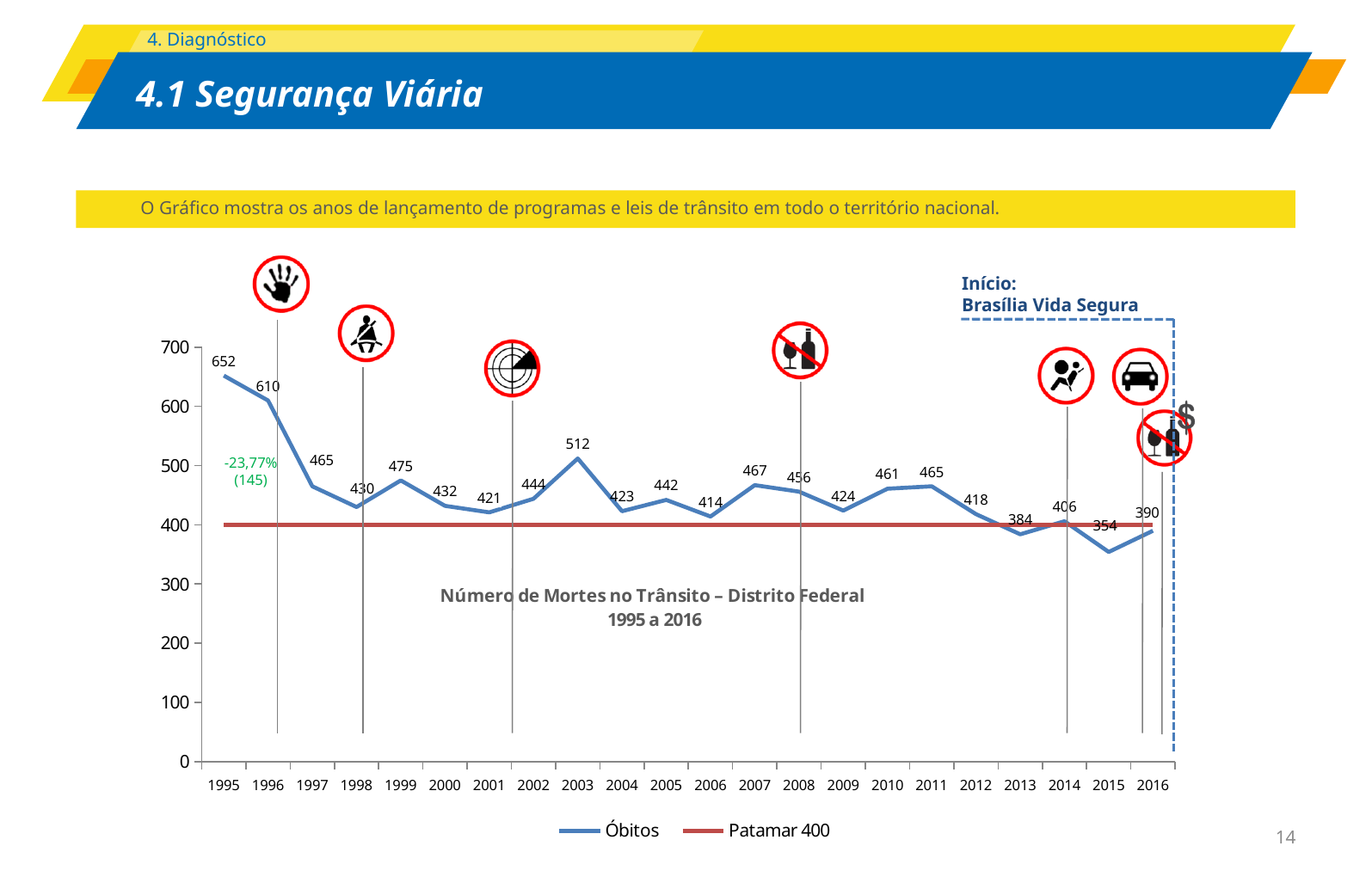
Which year has the highest number of deaths (Óbitos)? 1995 What is the number of deaths (Óbitos) in 2003? 512 How many series does the legend list? 2 How many years are plotted on the x axis? 22 What is the difference between the number of deaths in 1995 and in 1996? 42 What is the difference between the number of deaths in 2014 and in 2015? 52 Which year has the lowest number of deaths (Óbitos)? 2015 What type of chart is shown on the slide? line chart What is the number of deaths (Óbitos) in 2016? 390 What is the value of the red horizontal line labelled 'Patamar 400'? 400 Which year has more deaths, 1999 or 2000? 1999 What is the number of deaths (Óbitos) in 1995? 652